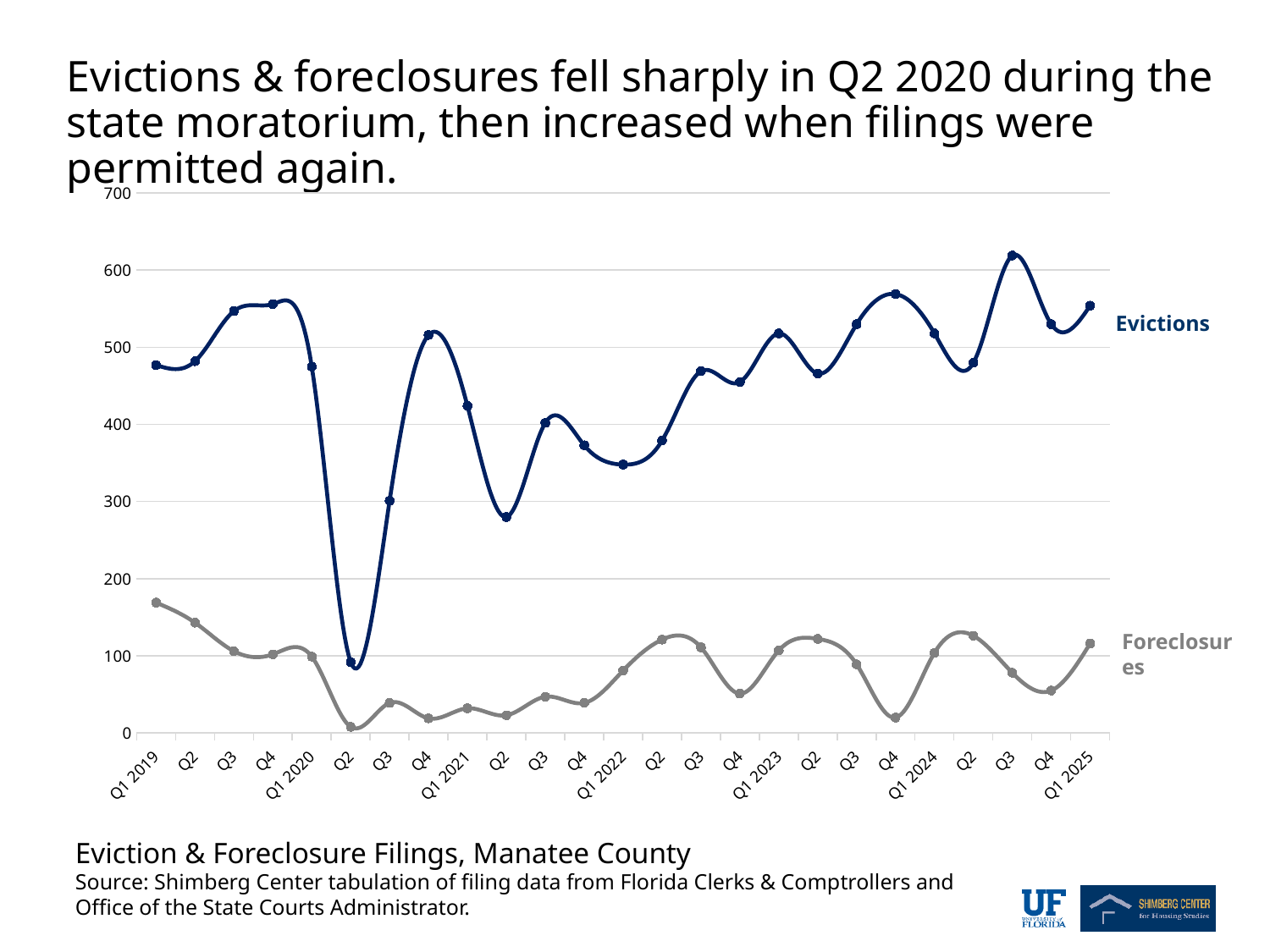
Is the value for Foreclosures in Q1 2019 greater or less than 150? greater Which series has the larger value in Q1 2025, Evictions or Foreclosures? Evictions What are the names of the two series plotted on the chart? Evictions and Foreclosures What kind of chart is shown on the slide? Line chart In which quarter do Foreclosures reach their lowest value? Q2 2020 In which quarter do Evictions reach their lowest value? Q2 2020 Is the value for Evictions in Q2 2020 greater or less than 200? less Is the value for Evictions in Q3 2024 greater or less than 600? greater How many quarterly data points does each series have, from Q1 2019 to Q1 2025? 25 How many series are plotted on the chart? 2 In which quarter do Evictions reach their highest value? Q3 2024 Do Foreclosures rise or fall from Q1 2019 to Q3 2019? Fall